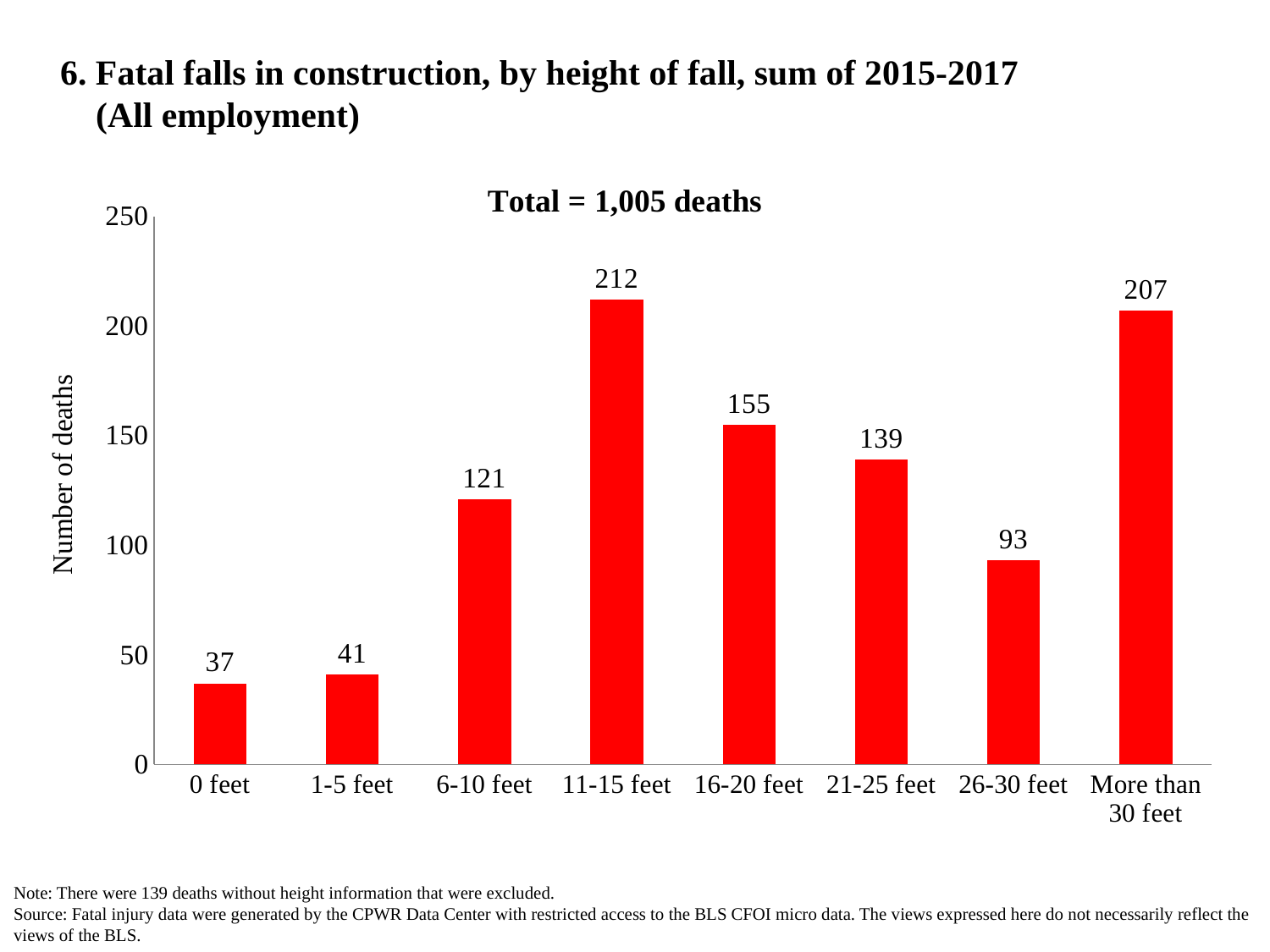
What is the total number of deaths stated on the chart? 1,005 deaths Which has more deaths: falls from 6-10 feet or falls from 21-25 feet? 21-25 feet What is the difference in deaths between the 1-5 feet and 0 feet categories? 4 Which height category has the lowest number of deaths? 0 feet What is the number of deaths for falls from 26-30 feet? 93 What kind of chart is shown on the slide? Bar chart What is the label of the y axis? Number of deaths How many height categories are shown on the x axis? 8 What is the difference in deaths between the 11-15 feet and 16-20 feet categories? 57 How many deaths are shown for falls from more than 30 feet? 207 Which height category has the highest number of deaths? 11-15 feet How many fatal falls occurred from a height of 11-15 feet? 212